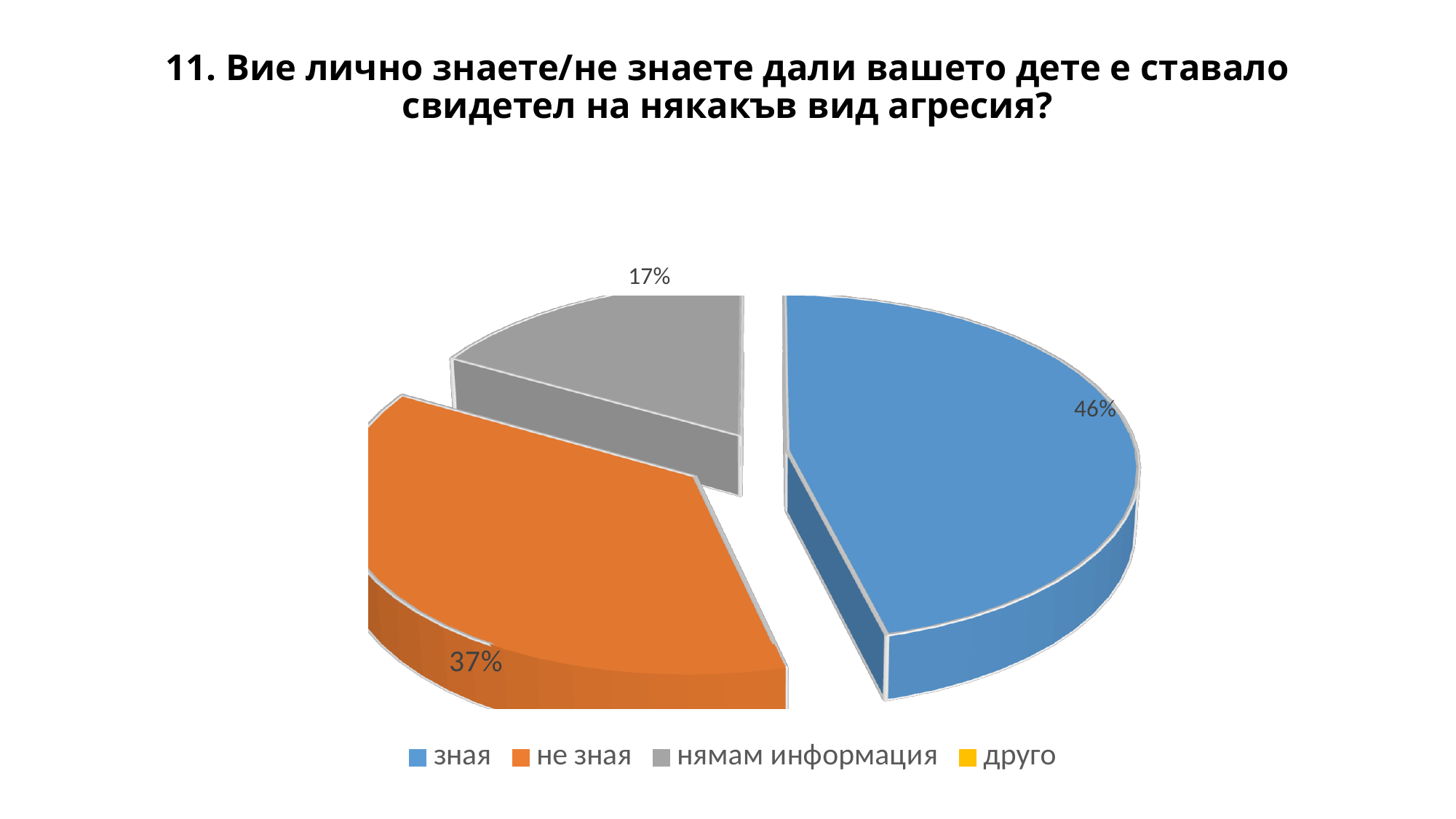
What is the difference in percentage points between "зная" and "не зная"? 9 Which legend entry is shown in yellow? друго Which of the labelled slices has the smallest share of the pie? нямам информация What percentage of the pie is labelled for "нямам информация"? 17% What percentage of the pie is labelled for "не зная"? 37% Which category has the largest share of the pie? зная What colour is the slice for "не зная"? orange Which is larger, the share for "не зная" or the share for "нямам информация"? не зная What type of chart is shown on the slide? pie chart How many entries does the legend list? 4 What is the difference in percentage points between "не зная" and "нямам информация"? 20 What percentage of the pie is labelled for "зная"? 46%